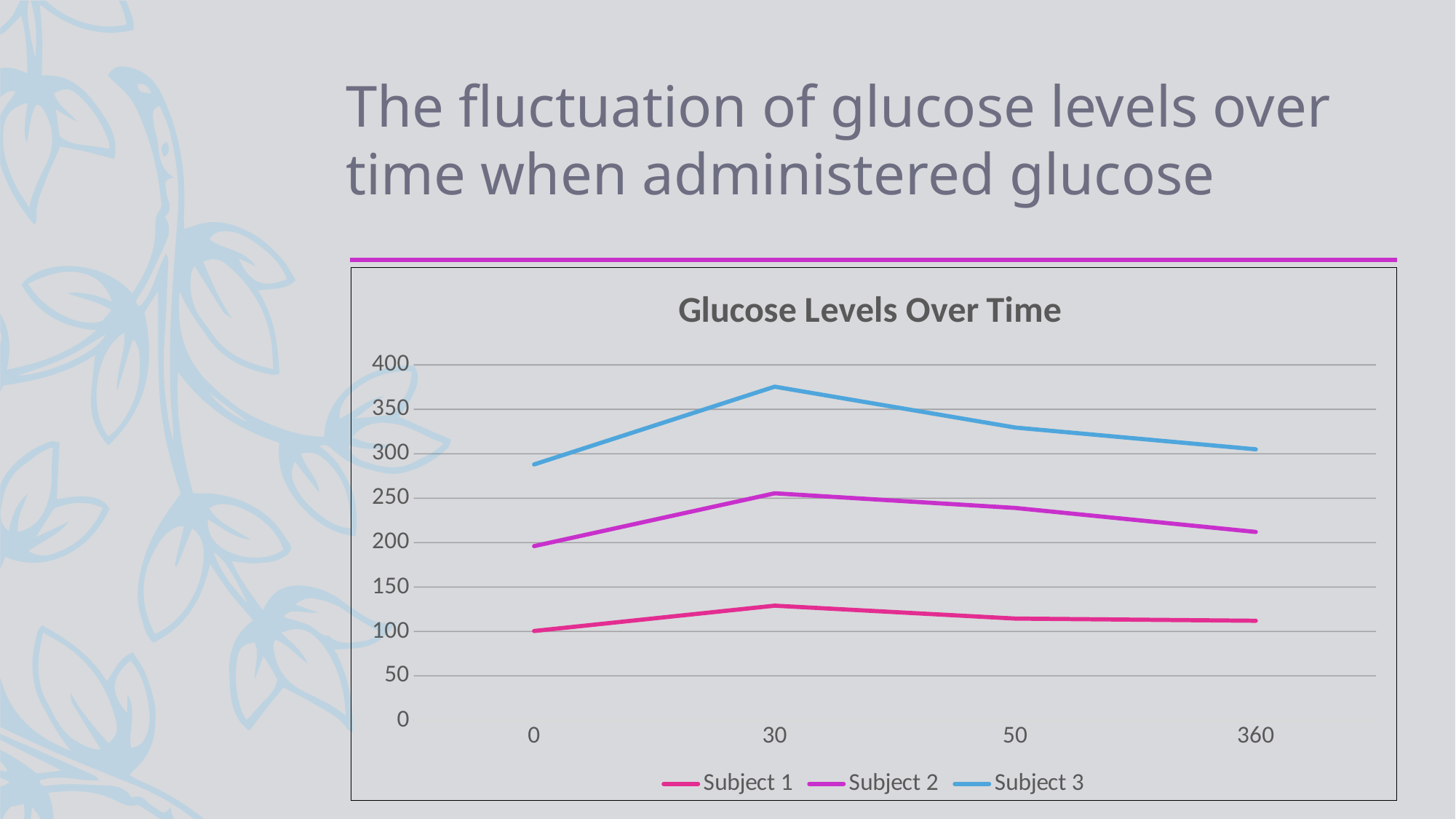
Is the value for Subject 1 at time 30 greater or less than 100? greater At which time point does Subject 2 reach its highest glucose level? 30 At which time point is Subject 1's glucose level lowest? 0 Which series is drawn in blue in the chart? Subject 3 Does Subject 3's glucose level rise or fall from time 30 to time 360? fall How many time points are plotted along the x axis of the chart? 4 How many series does the legend of the chart list? 3 What is the title of the chart? Glucose Levels Over Time What kind of chart is shown on the slide? line chart Is the value for Subject 3 at time 0 greater or less than 300? less